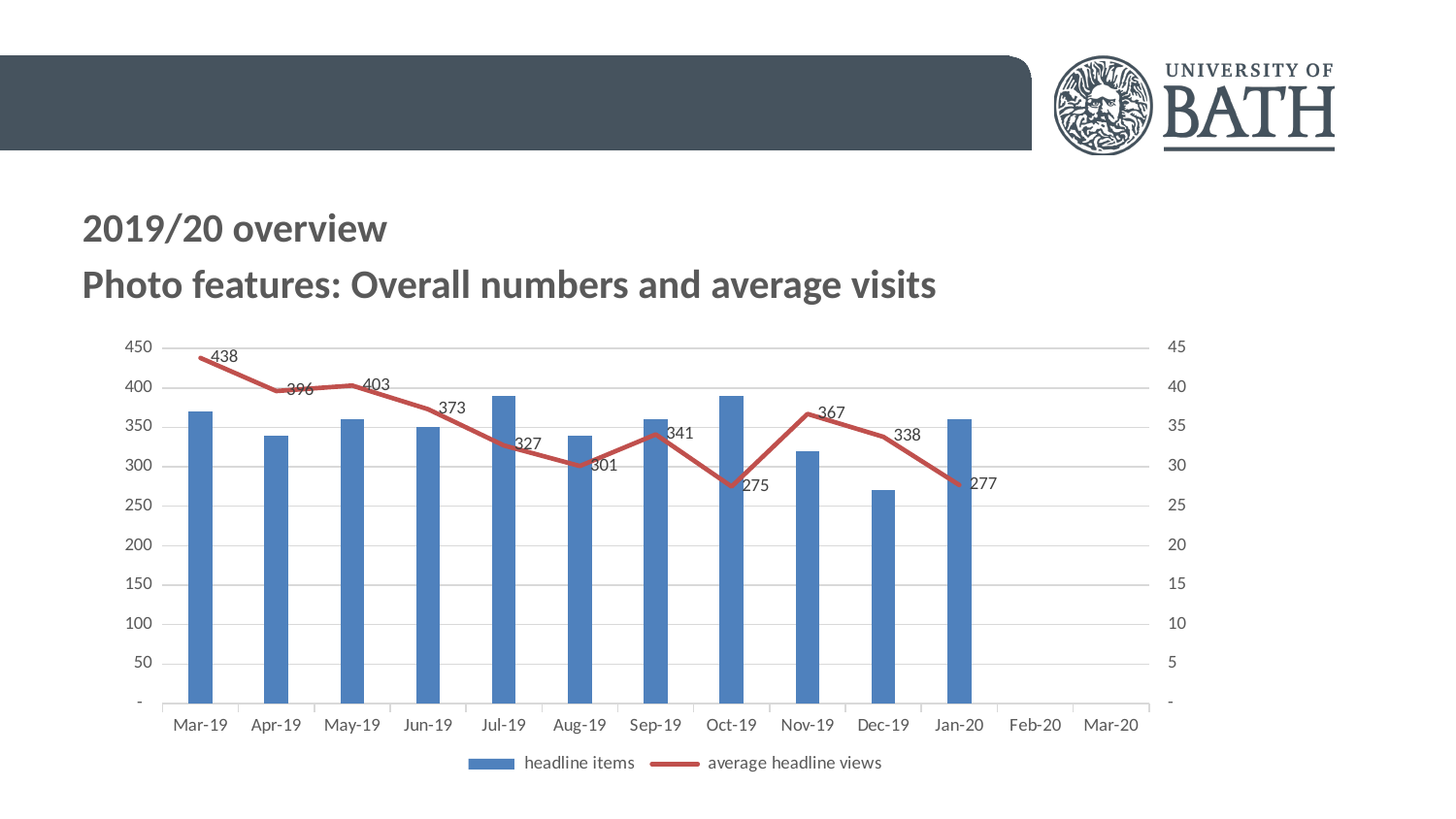
What is the average headline views value for Oct-19? 275 What kind of chart is shown on the slide? Combined bar and line chart What is the difference in average headline views between Mar-19 and Jan-20? 161 Which month has the lowest average headline views? Oct-19 What is the difference in average headline views between Nov-19 and Dec-19? 29 What is the average headline views value for Mar-19? 438 Which month has the highest average headline views? Mar-19 Which month has the lowest headline items bar? Dec-19 Is the headline items value for Dec-19 greater or less than 30 on the right-hand axis? less Which month has higher average headline views, Aug-19 or Sep-19? Sep-19 How many series does the legend list? 2 What is the average headline views value for Jan-20? 277